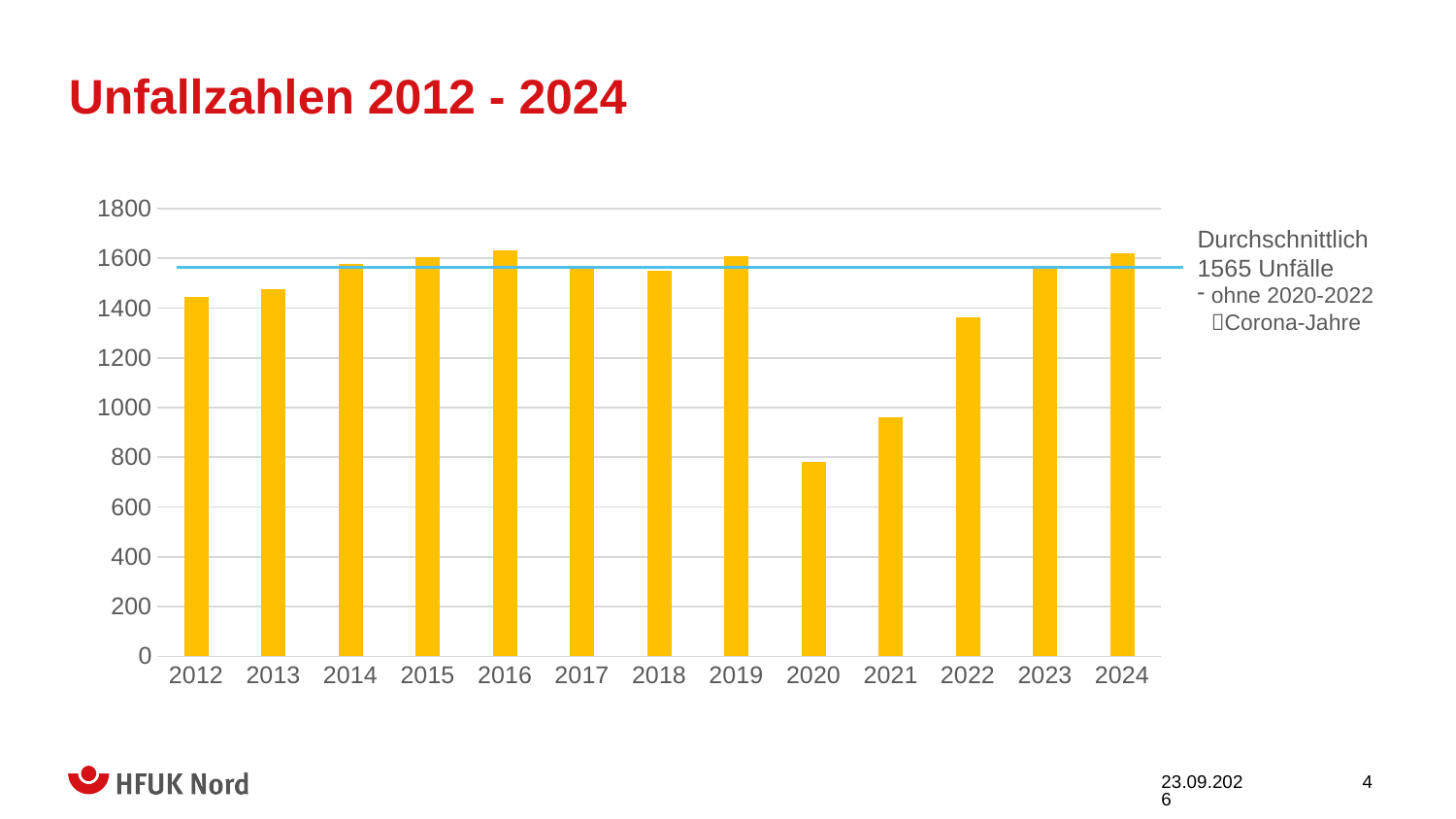
Which year has the larger value, 2019 or 2022? 2019 What kind of chart is shown on the slide? bar chart Is the value for 2022 greater or less than 1400? less What average number of accidents does the horizontal line in the chart represent, according to the text next to it? 1565 Unfälle Which year has the larger value, 2020 or 2021? 2021 Is the value for 2020 greater or less than 1000? less Which year has the lowest number of accidents in the chart? 2020 How many years are shown on the x axis of the chart? 13 Do the values rise or fall from 2020 to 2024? rise Is the value for 2013 greater or less than 1600? less